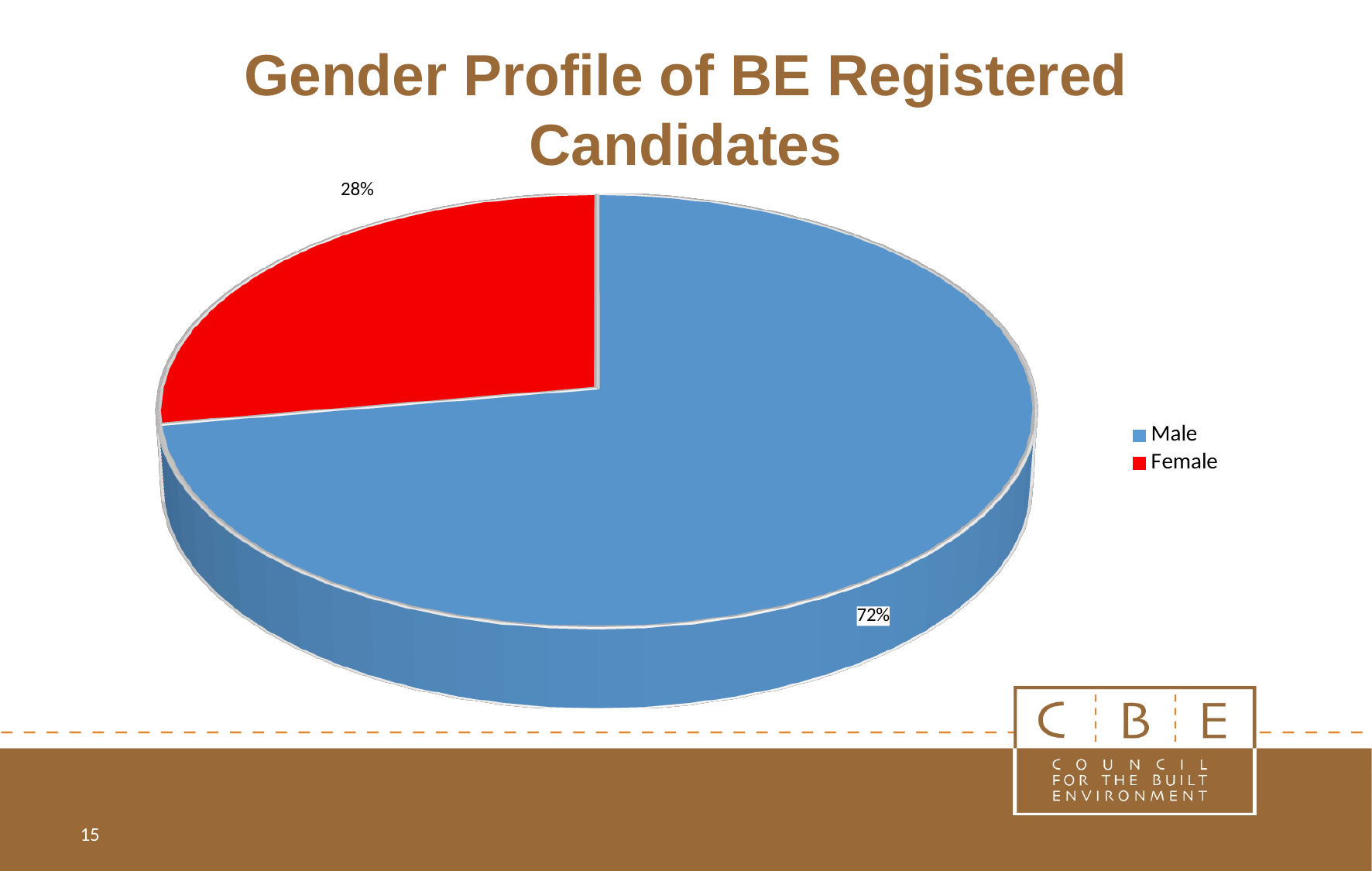
Which category has the largest share of the pie? Male Which is larger, the Male share or the Female share? Male What is the title of the chart? Gender Profile of BE Registered Candidates What is the difference in percentage points between the Male and Female shares? 44 What colour represents the Female slice? red What percentage of BE registered candidates are Male? 72% How many entries does the legend list? 2 How many categories does the pie chart show? 2 What kind of chart is shown on the slide? pie chart Which category has the smallest share of the pie? Female What percentage of BE registered candidates are Female? 28%